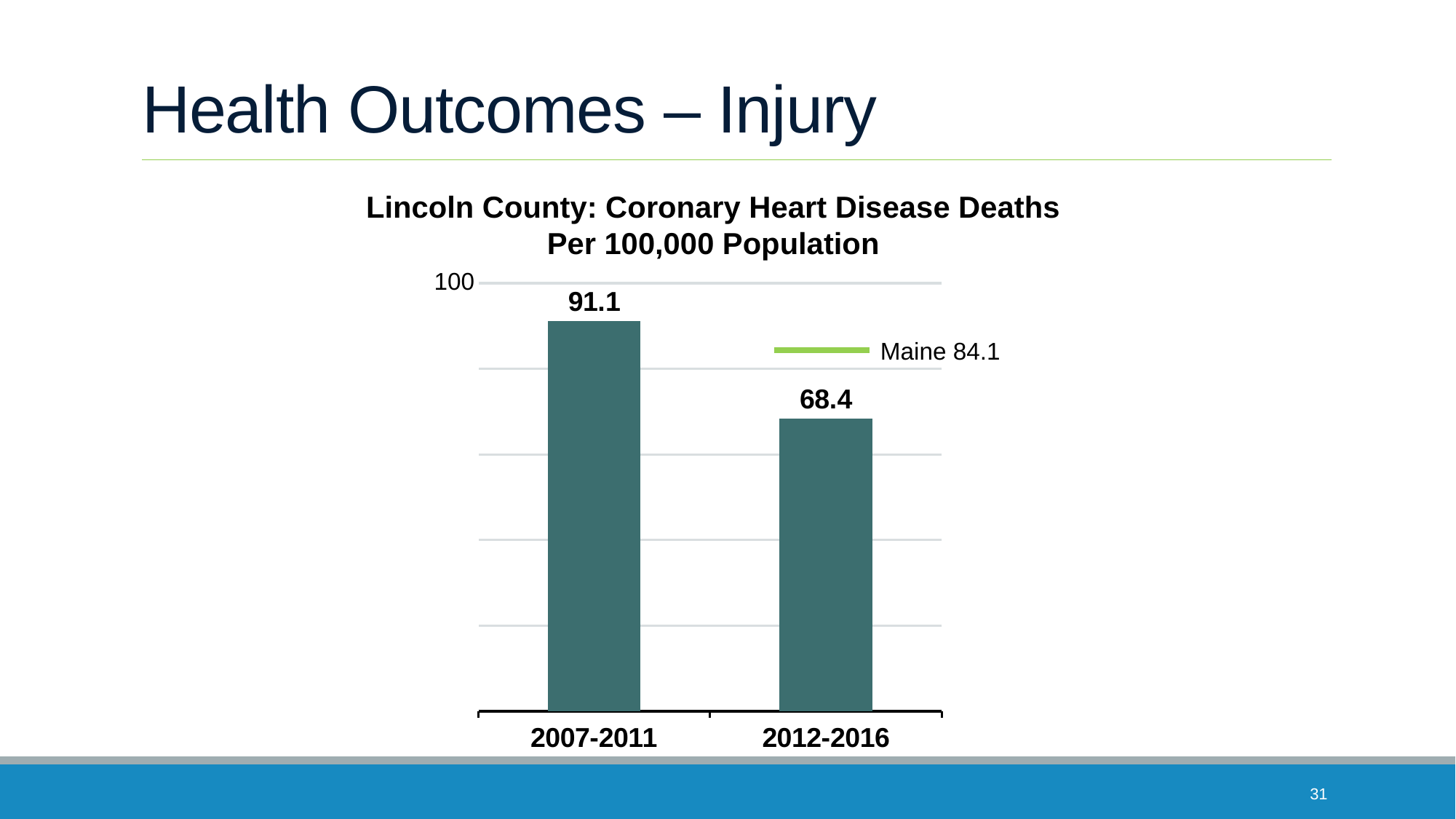
What is the title of the chart? Lincoln County: Coronary Heart Disease Deaths Per 100,000 Population Do the values rise or fall from 2007-2011 to 2012-2016? fall Which period has the highest value? 2007-2011 What kind of chart is this? bar chart Which period has the lowest value? 2012-2016 What is the value for 2012-2016? 68.4 Is the value for 2007-2011 greater or less than the Maine value of 84.1? greater What is the Maine value shown by the reference line? 84.1 How many time periods are shown on the chart? 2 What is the difference between the 2007-2011 and 2012-2016 values? 22.7 Which is larger, the 2012-2016 value or the Maine value? Maine What is the value for 2007-2011? 91.1